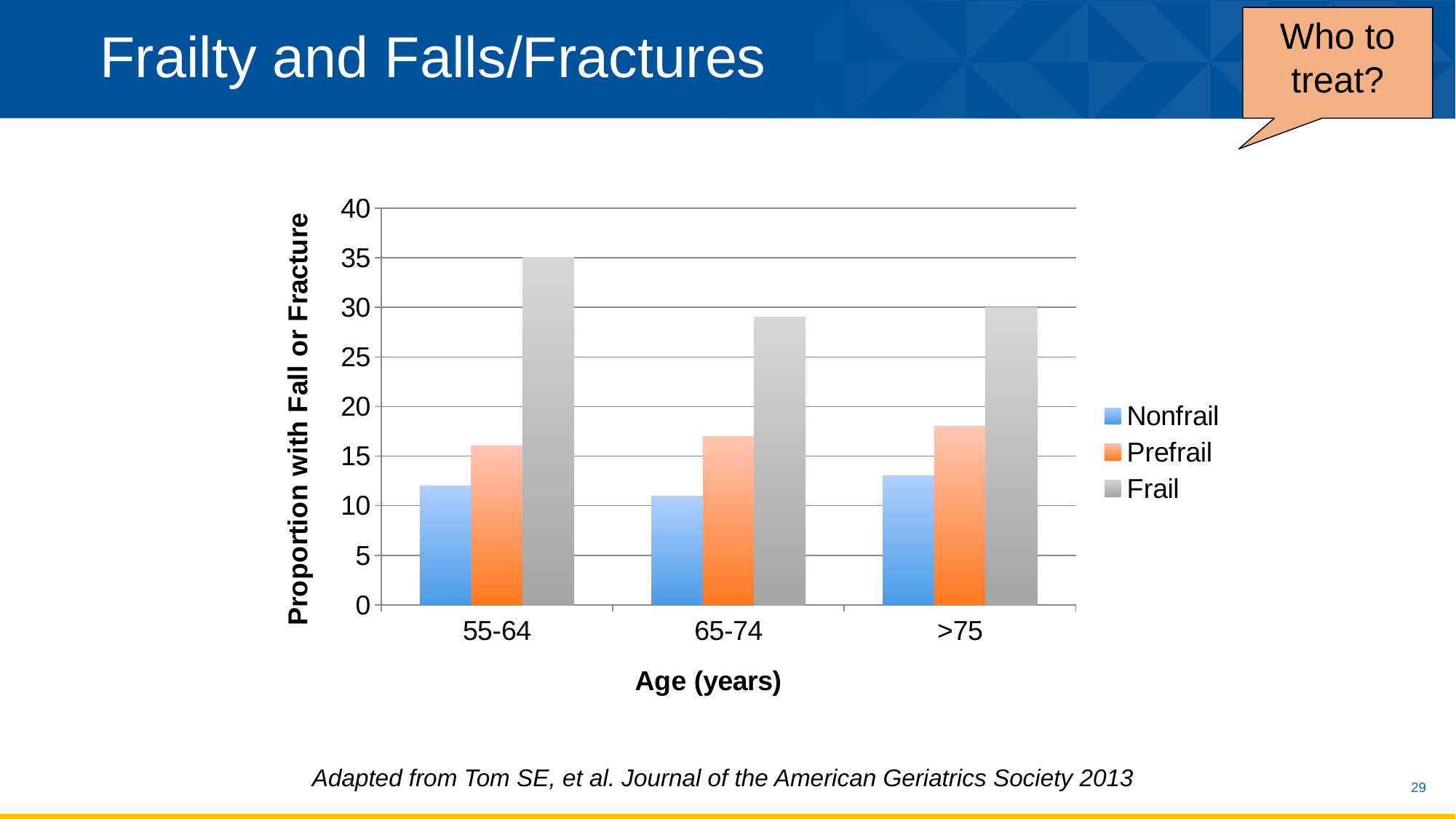
Is the value for Frail in the 65-74 age group greater or less than 25? greater Is the value for Nonfrail in the 55-64 age group greater or less than 15? less What is the value for Frail in the 55-64 age group? 35 Which series has the lowest value in the 65-74 age group? Nonfrail Which is larger in the 65-74 age group, Prefrail or Nonfrail? Prefrail What is the value for Frail in the >75 age group? 30 What is the label of the y axis? Proportion with Fall or Fracture How many series does the legend list? 3 What kind of chart is shown on the slide? bar chart Is the value for Prefrail in the >75 age group greater or less than 15? greater How many age groups are shown on the x axis? 3 Which age group has the highest Frail value? 55-64